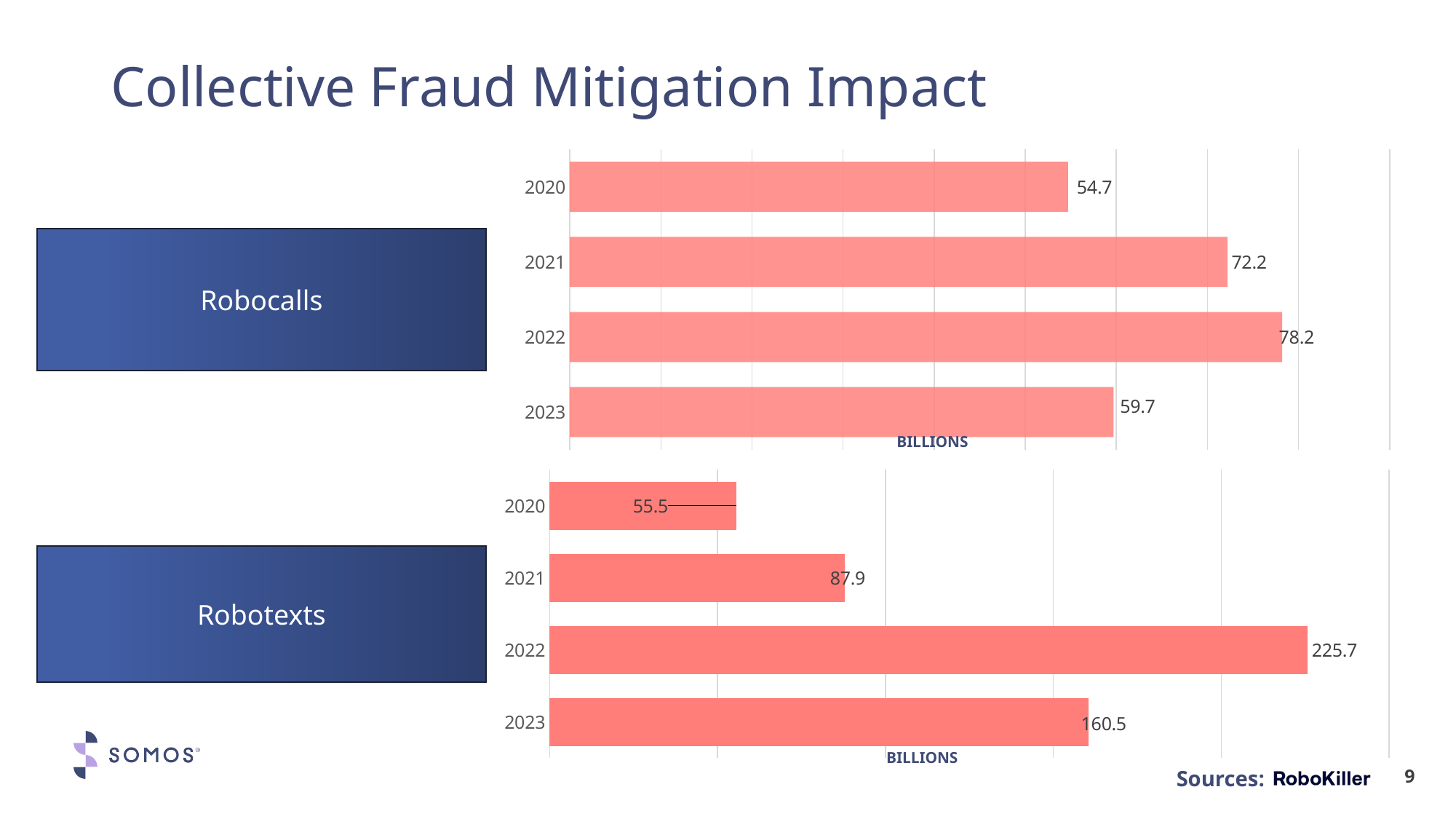
In the Robotexts chart, which is larger, the value for 2023 or the value for 2020? 2023 In the Robotexts chart, what is the difference between the 2022 and 2021 values? 137.8 In the Robotexts chart, which year has the highest value? 2022 In the Robocalls chart, which year has the lowest value? 2020 In the Robocalls chart, do the values rise or fall from 2020 to 2022? Rise What source is cited for the charts on the slide? RoboKiller In the Robocalls chart, what is the value for 2022? 78.2 In the Robocalls chart, how many years are plotted? 4 In the Robotexts chart, what is the value for 2021? 87.9 What unit label is shown beneath each chart? BILLIONS In the Robocalls chart, what is the difference between the 2022 and 2023 values? 18.5 What kind of chart is the Robotexts chart? Bar chart